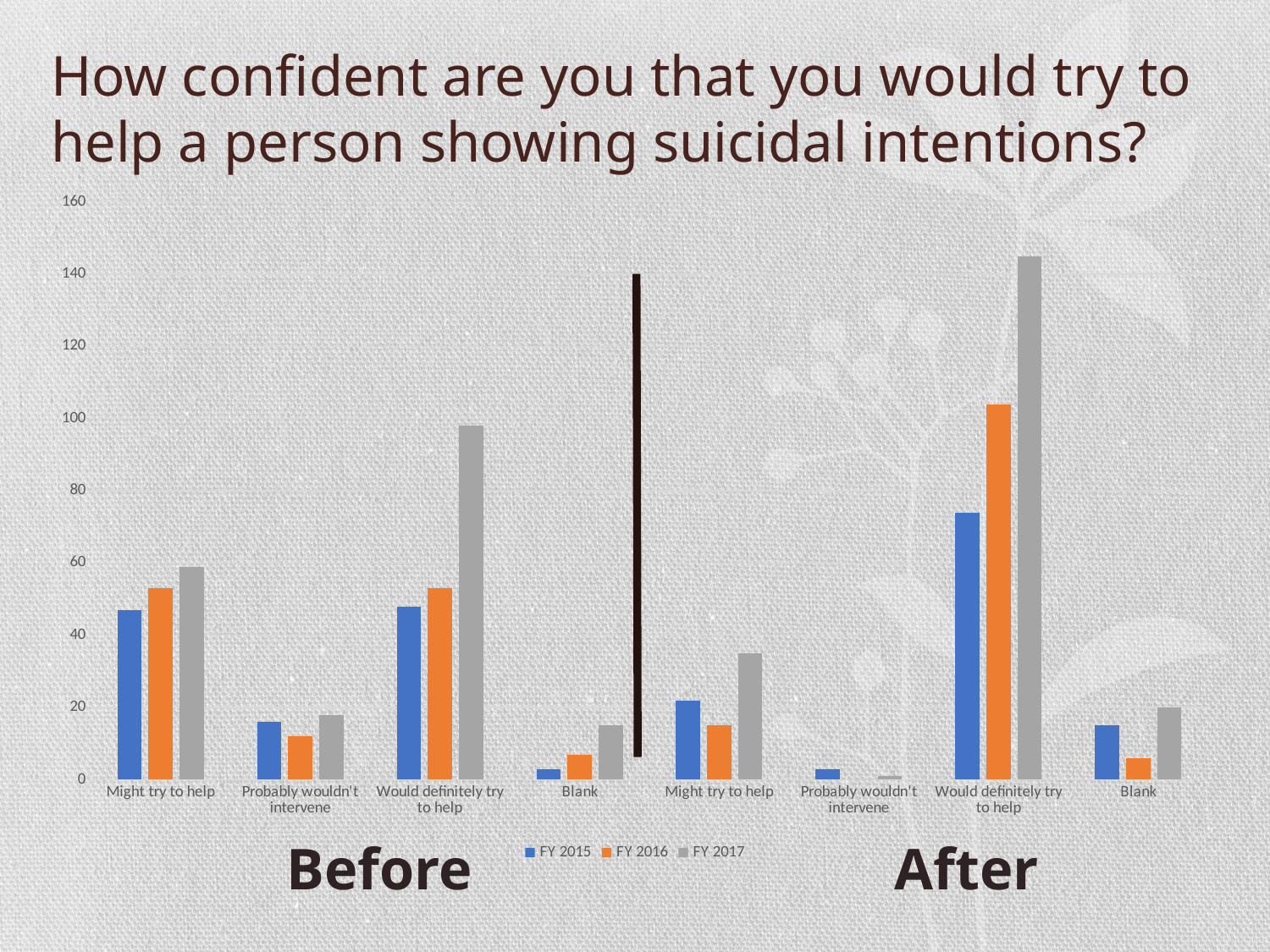
In the After section, which category has the lowest bars? Probably wouldn't intervene What kind of chart is shown on the slide? bar chart Is the FY 2016 value for 'Would definitely try to help' in the After section greater or less than 80? greater Is the FY 2017 value for 'Would definitely try to help' in the After section greater or less than 120? greater How many categories are shown along the x axis in total? 8 Is the FY 2017 value for 'Would definitely try to help' in the Before section greater or less than 80? greater How many series does the legend list? 3 What are the series names listed in the legend? FY 2015, FY 2016, FY 2017 For 'Might try to help' in FY 2017, which is larger: the Before value or the After value? Before In the After section for 'Would definitely try to help', which is larger: FY 2015 or FY 2016? FY 2016 Which category and series has the tallest bar on the chart? Would definitely try to help (After), FY 2017